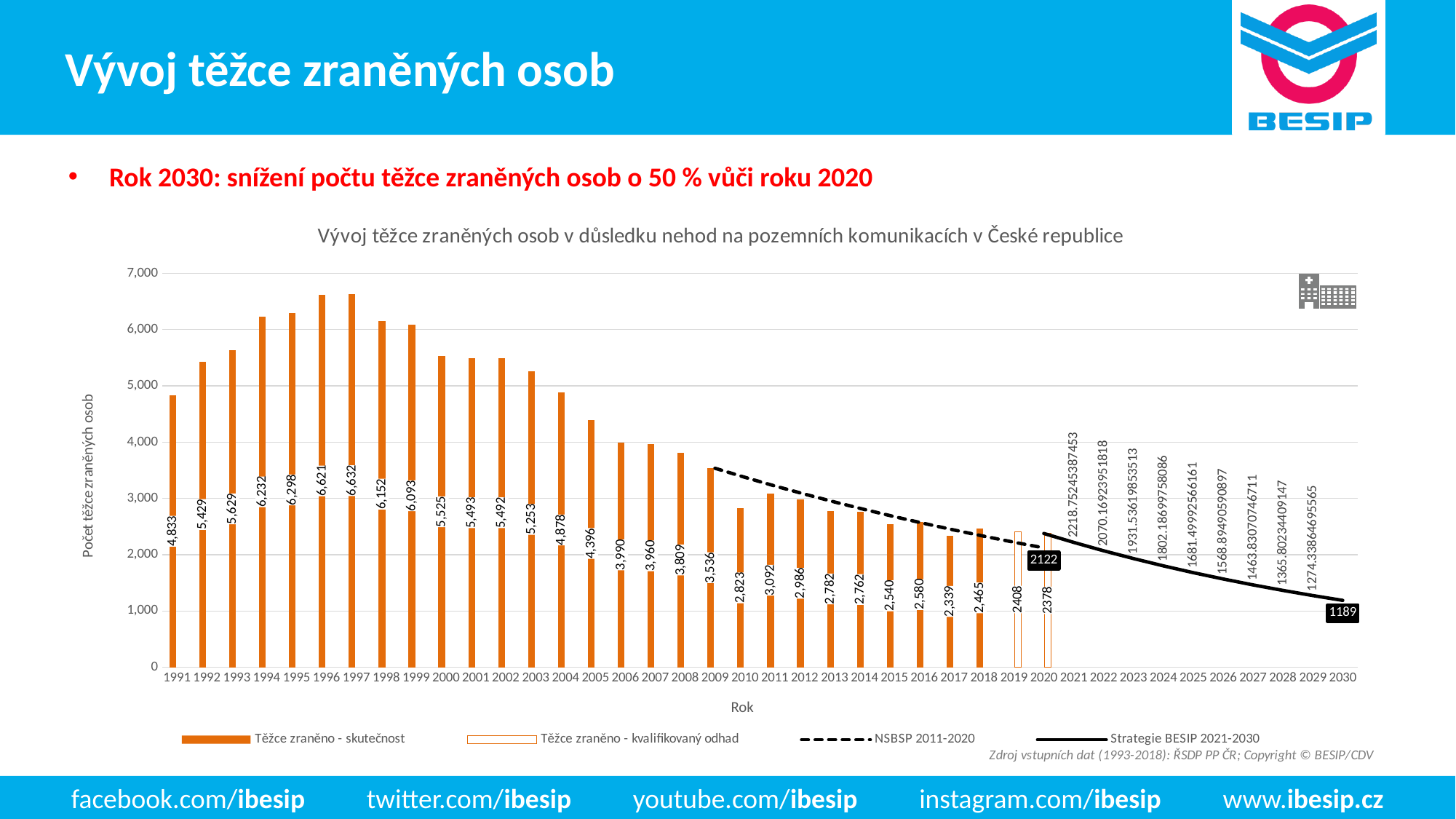
Do the values rise or fall from 1991 to 1997? Rise What is the value for 2010 in the chart? 2,823 What kind of chart is used for the 'Těžce zraněno - skutečnost' series? Bar chart How many series does the legend list? 4 What is the qualified estimate value for 2019? 2408 What is the title of the vertical axis? Počet těžce zraněných osob What value does the 'Strategie BESIP 2021-2030' line reach in 2030? 1189 Which year has the highest number of seriously injured persons? 1997 Which year has the larger value, 2015 or 2016? 2016 What is the value for 1991 in the chart? 4,833 What is the difference between the values for 1997 and 1996? 11 What is the difference between the values for 2018 and 2017? 126